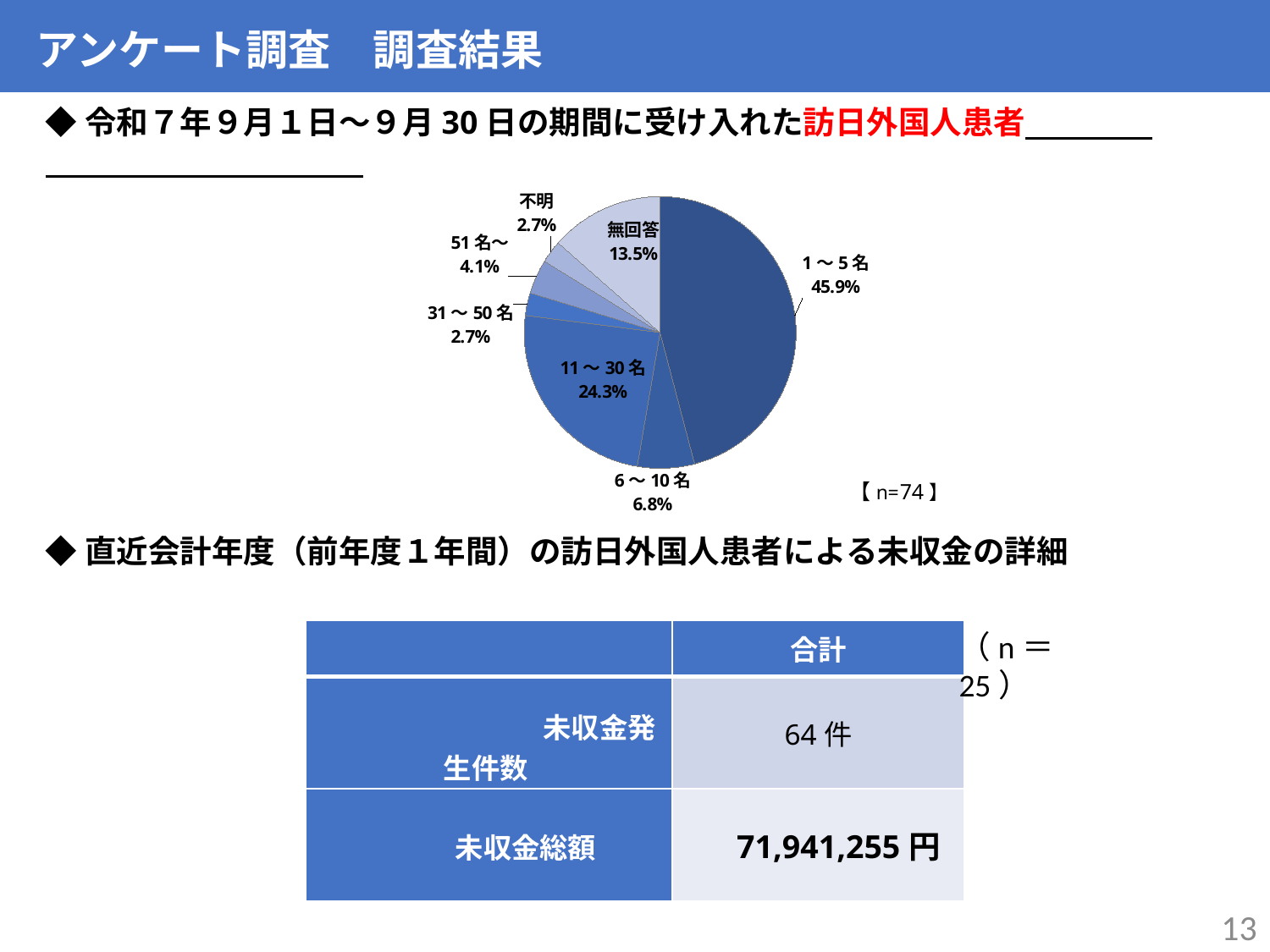
What share of the pie does the 1～5名 slice represent? 45.9% What is the value shown for the 51名～ slice? 4.1% What is the value shown for the 無回答 slice? 13.5% What kind of chart is shown on the slide? pie chart What is the combined share of the 31～50名 and 不明 slices? 5.4% Which category has the largest slice of the pie? 1～5名 What is the value shown for the 11～30名 slice? 24.3% How many slices does the pie chart have? 7 Which is larger, the 無回答 slice or the 6～10名 slice? 無回答 What is the value shown for the 6～10名 slice? 6.8% What is the difference in percentage points between the 1～5名 slice and the 11～30名 slice? 21.6 What sample size (n) is noted next to the pie chart? n=74